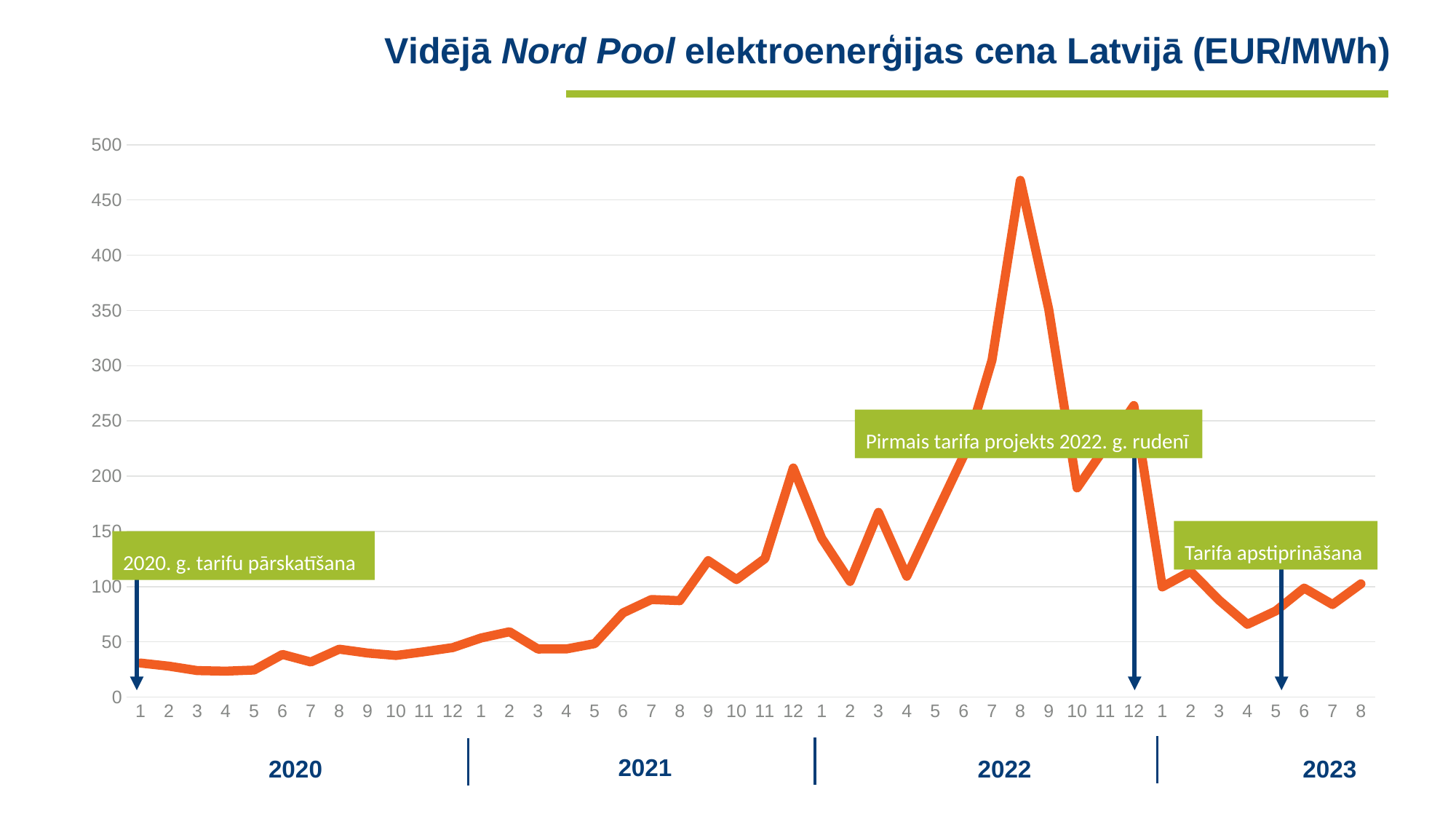
What kind of chart is shown on the slide? line chart Which month has the highest average Nord Pool electricity price on the chart? August 2022 Is the value for April 2023 greater or less than 100? less Does the price generally rise or fall from January 2020 to August 2022? rise Which is larger, the value for March 2022 or the value for February 2022? March 2022 What is the title of the chart? Vidējā Nord Pool elektroenerģijas cena Latvijā (EUR/MWh) How many monthly data points are plotted on the chart? 44 Is the value for December 2022 greater or less than 200? greater Does the price generally rise or fall from August 2022 to April 2023? fall Is the value for December 2021 greater or less than 150? greater